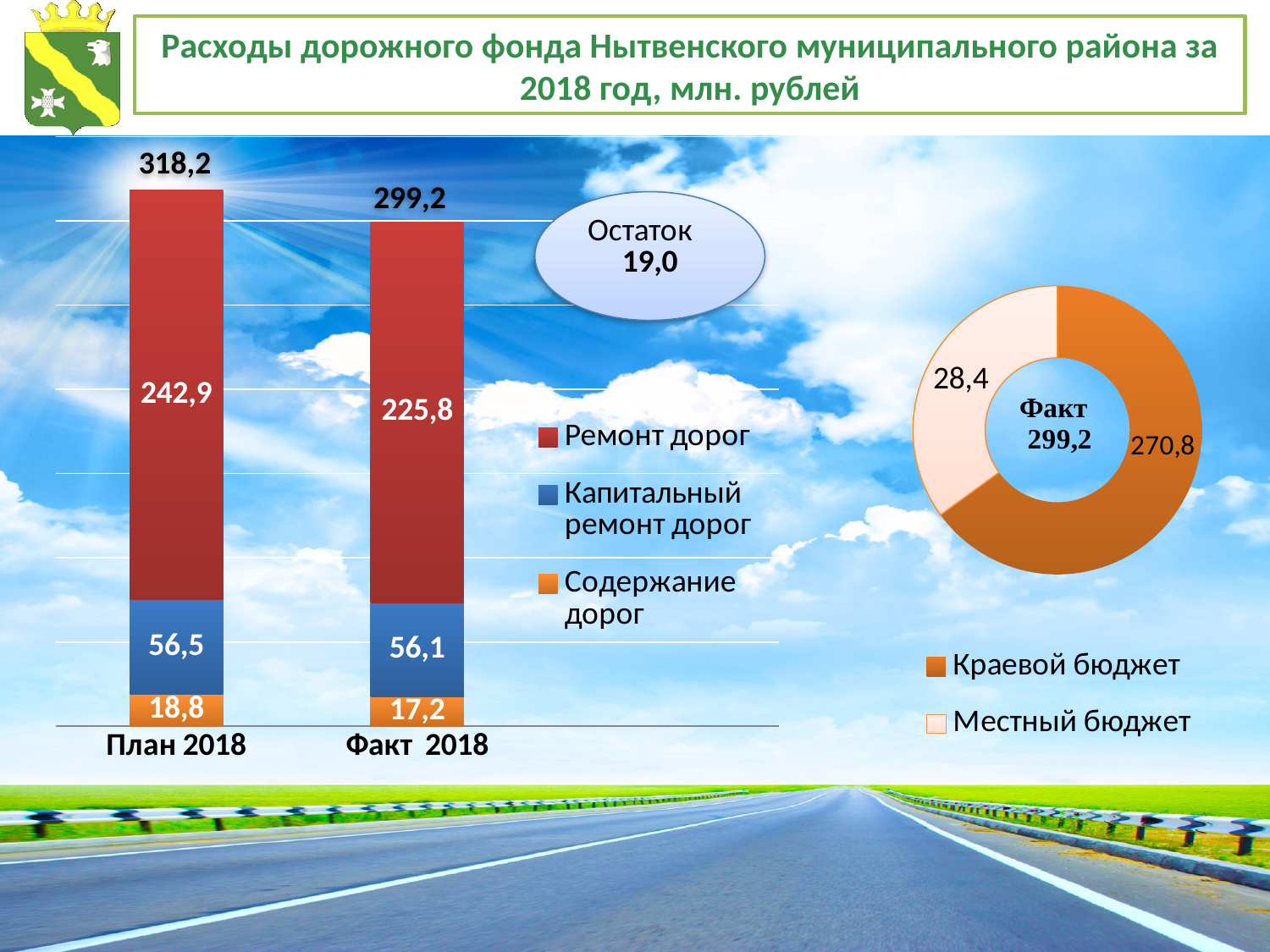
In the doughnut chart on the right, which category is the largest? Краевой бюджет In the doughnut chart on the right, what is the value for Краевой бюджет? 270,8 In the stacked bar chart on the left, what is the difference between the totals of План 2018 and Факт 2018? 19,0 In the stacked bar chart on the left, what is the value of Ремонт дорог for План 2018? 242,9 In the stacked bar chart on the left, what is the total of the Факт 2018 bar? 299,2 In the stacked bar chart on the left, what is the total of the План 2018 bar? 318,2 In the stacked bar chart on the left, which is larger: Капитальный ремонт дорог for План 2018 or for Факт 2018? План 2018 How many series does the legend of the stacked bar chart on the left list? 3 In the stacked bar chart on the left, what is the difference between the Ремонт дорог values for План 2018 and Факт 2018? 17,1 In the doughnut chart on the right, what is the value for Местный бюджет? 28,4 In the stacked bar chart on the left, what is the value of Содержание дорог for Факт 2018? 17,2 What kind of chart is the chart on the left of the slide? Stacked bar chart